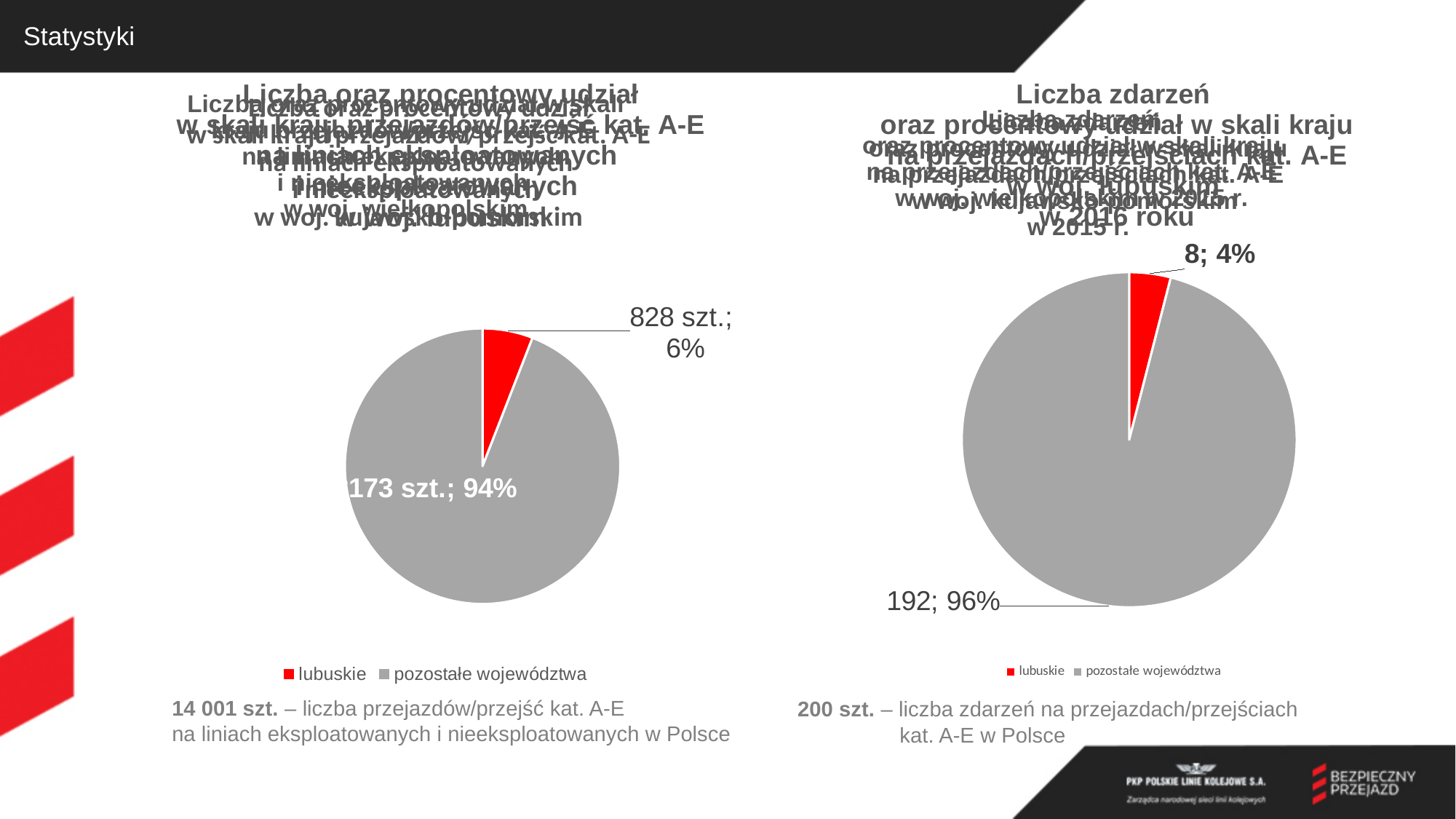
In the left pie chart, which slice is larger, lubuskie or pozostałe województwa? pozostałe województwa In the right pie chart, what is the total of the two slices? 200 In the left pie chart, what share of the pie does lubuskie have? 6% What kind of chart is the left chart on the slide? pie chart How many entries does the legend of the left pie chart list? 2 In the right pie chart, what value is shown for lubuskie? 8 In the right pie chart, what colour is the lubuskie slice? red In the right pie chart, what value is shown for pozostałe województwa? 192 In the left pie chart, what share of the pie does pozostałe województwa have? 94% In the right pie chart, what is the difference between the values for pozostałe województwa and lubuskie? 184 In the left pie chart, what value is shown for lubuskie? 828 szt. In the right pie chart, what share of the pie does lubuskie have? 4%